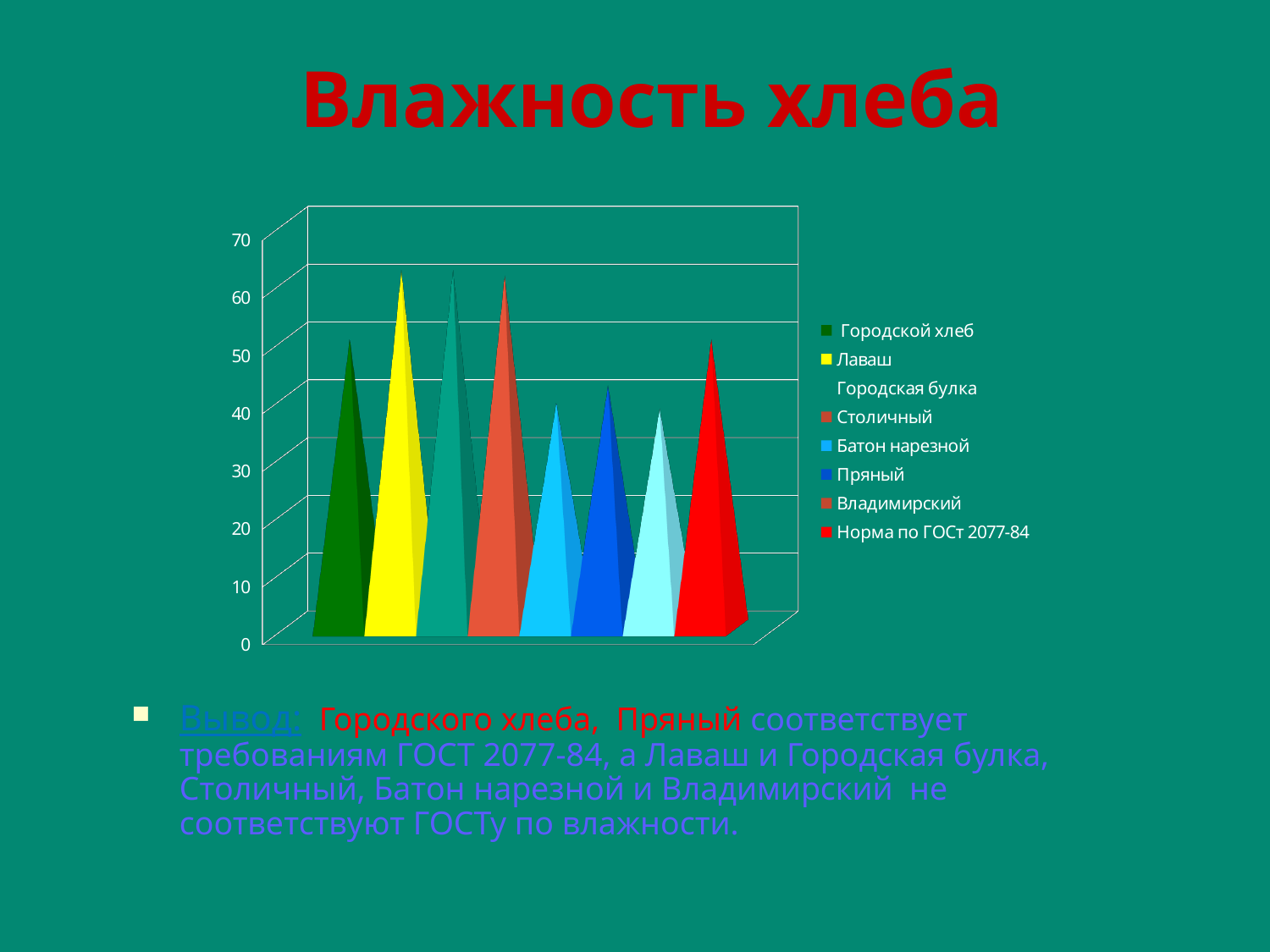
Is the value for Пряный greater or less than 50? less How many series does the legend list? 8 How many bars are plotted on the chart? 8 Is the value for Лаваш greater or less than 50? greater What is the title of the chart? Влажность хлеба What colour is used for the series Норма по ГОСт 2077-84 in the legend? red Which is larger, the value for Лаваш or the value for Батон нарезной? Лаваш Is the value for Городской хлеб greater or less than 40? greater What kind of chart is shown on the slide? bar chart Which is larger, the value for Норма по ГОСт 2077-84 or the value for Владимирский? Норма по ГОСт 2077-84